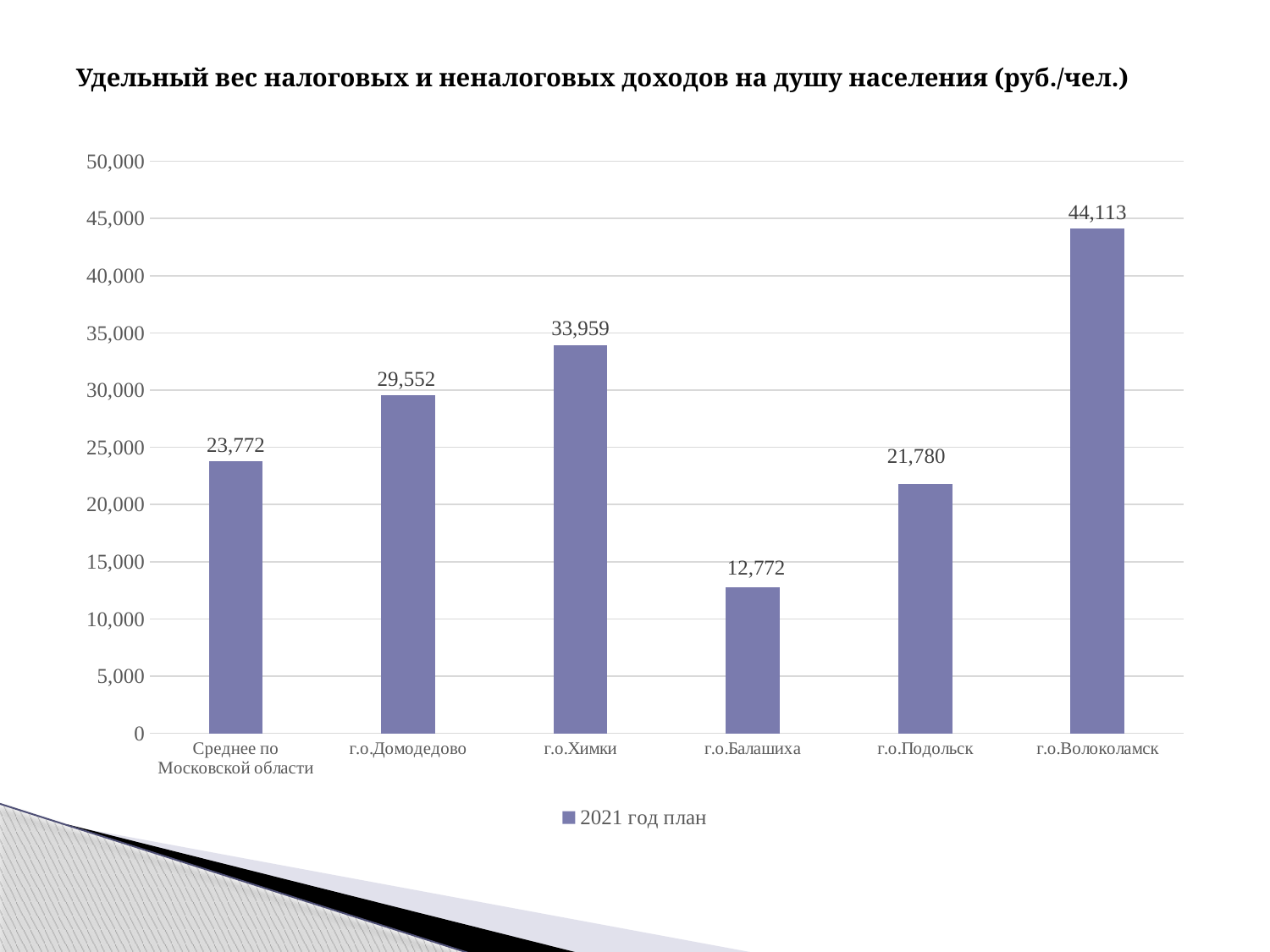
How many series does the legend list? 1 Which is larger, the value for г.о.Химки or the value for г.о.Подольск? г.о.Химки Which category has the lowest value? г.о.Балашиха Is the value for г.о.Подольск greater or less than 25,000? less What kind of chart is shown on the slide? bar chart What is the difference between the values for г.о.Домодедово and г.о.Подольск? 7,772 How many categories are shown on the x axis? 6 Which category has the highest value? г.о.Волоколамск What is the value for г.о.Балашиха? 12,772 What is the value for Среднее по Московской области? 23,772 What is the difference between the values for г.о.Волоколамск and г.о.Химки? 10,154 What is the value for г.о.Домодедово? 29,552